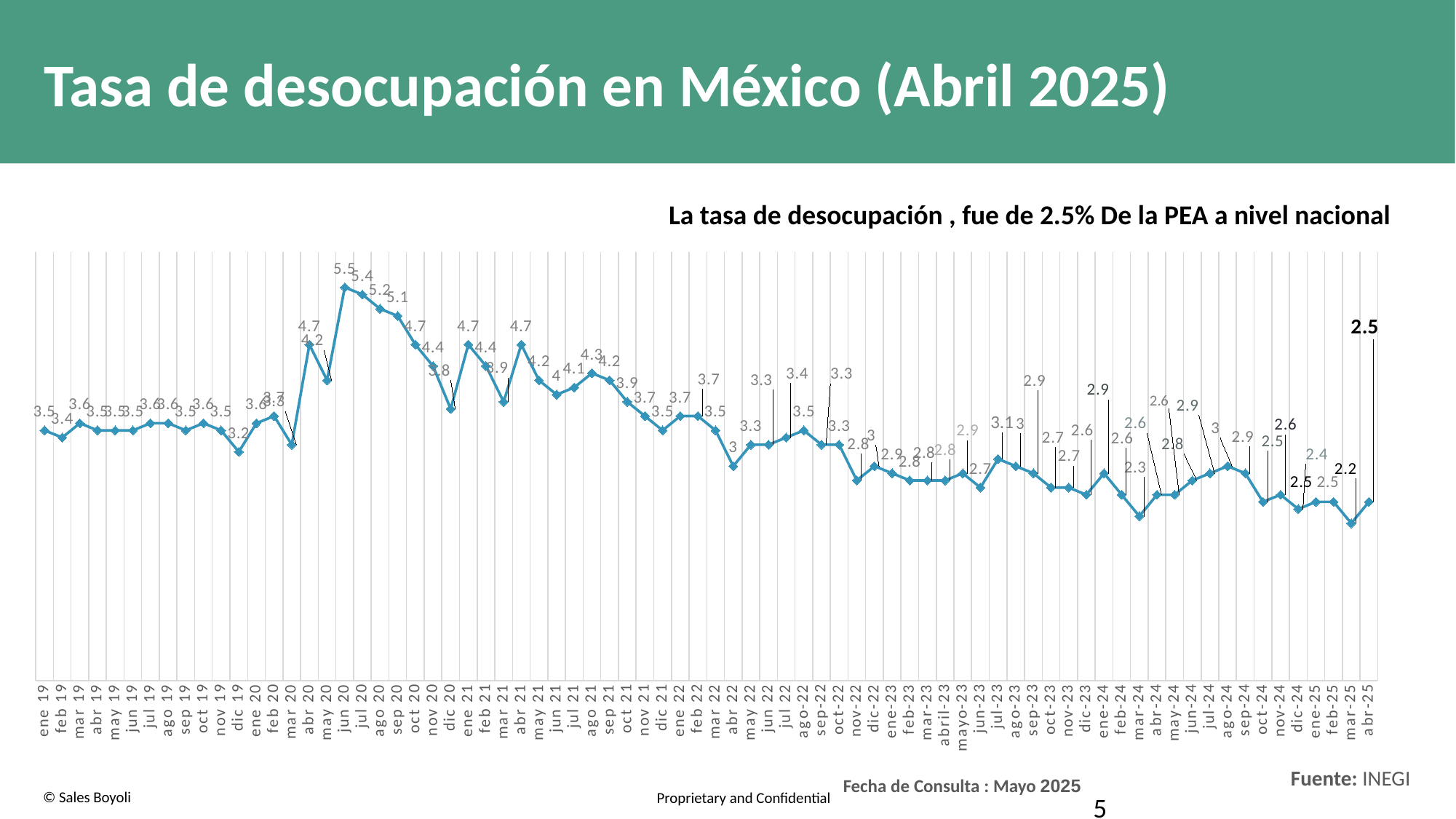
What is the title of the slide containing the chart? Tasa de desocupación en México (Abril 2025) What kind of chart is shown on the slide? line chart What is the difference between the value for abr-25 and the value for mar-25? 0.3 Which month has the highest value on the chart? jun 20 What is the difference between the value for jun 20 and the value for mar-25? 3.3 Which month has the lowest value on the chart? mar-25 Does the line generally rise or fall from jun 20 to abr-25? fall What is the value plotted for dic 19? 3.2 What is the value plotted for ene 19? 3.5 What is the unemployment rate value for abr-25? 2.5 Which is larger, the value for abr 20 or the value for may 20? abr 20 What is the value plotted for jun 20? 5.5